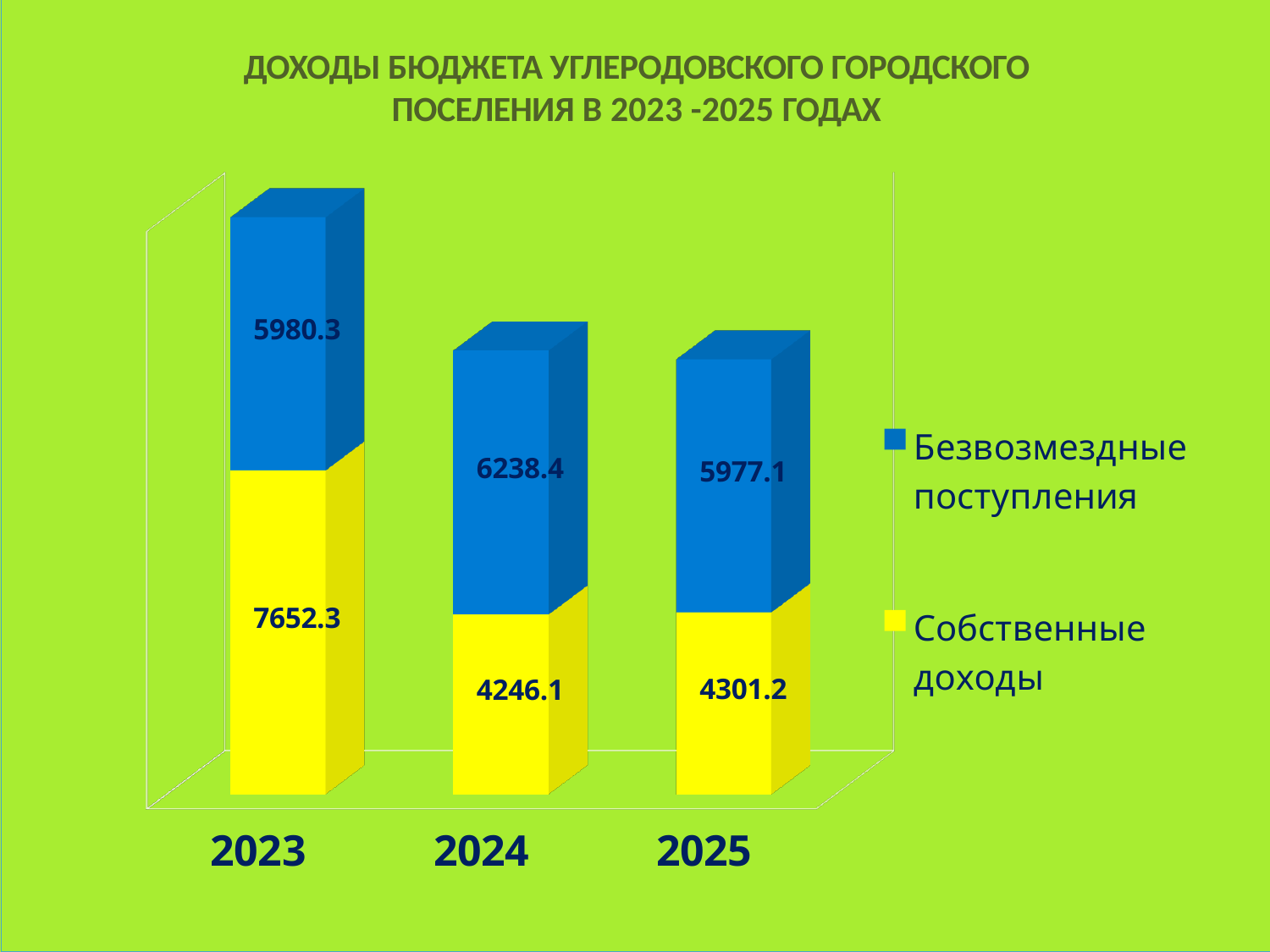
In which year is Безвозмездные поступления highest? 2024 What type of chart is shown on the slide? Stacked bar chart What is the value of Безвозмездные поступления for 2024? 6238.4 How many years are shown on the x axis? 3 In which year is Собственные доходы highest? 2023 What is the value of Собственные доходы for 2023? 7652.3 What is the value of Собственные доходы for 2025? 4301.2 Which colour represents Собственные доходы in the chart? Yellow How many series does the legend list? 2 What is the total of the stacked bar for 2023? 13632.6 What is the value of Безвозмездные поступления for 2025? 5977.1 What is the difference between Собственные доходы in 2023 and in 2024? 3406.2